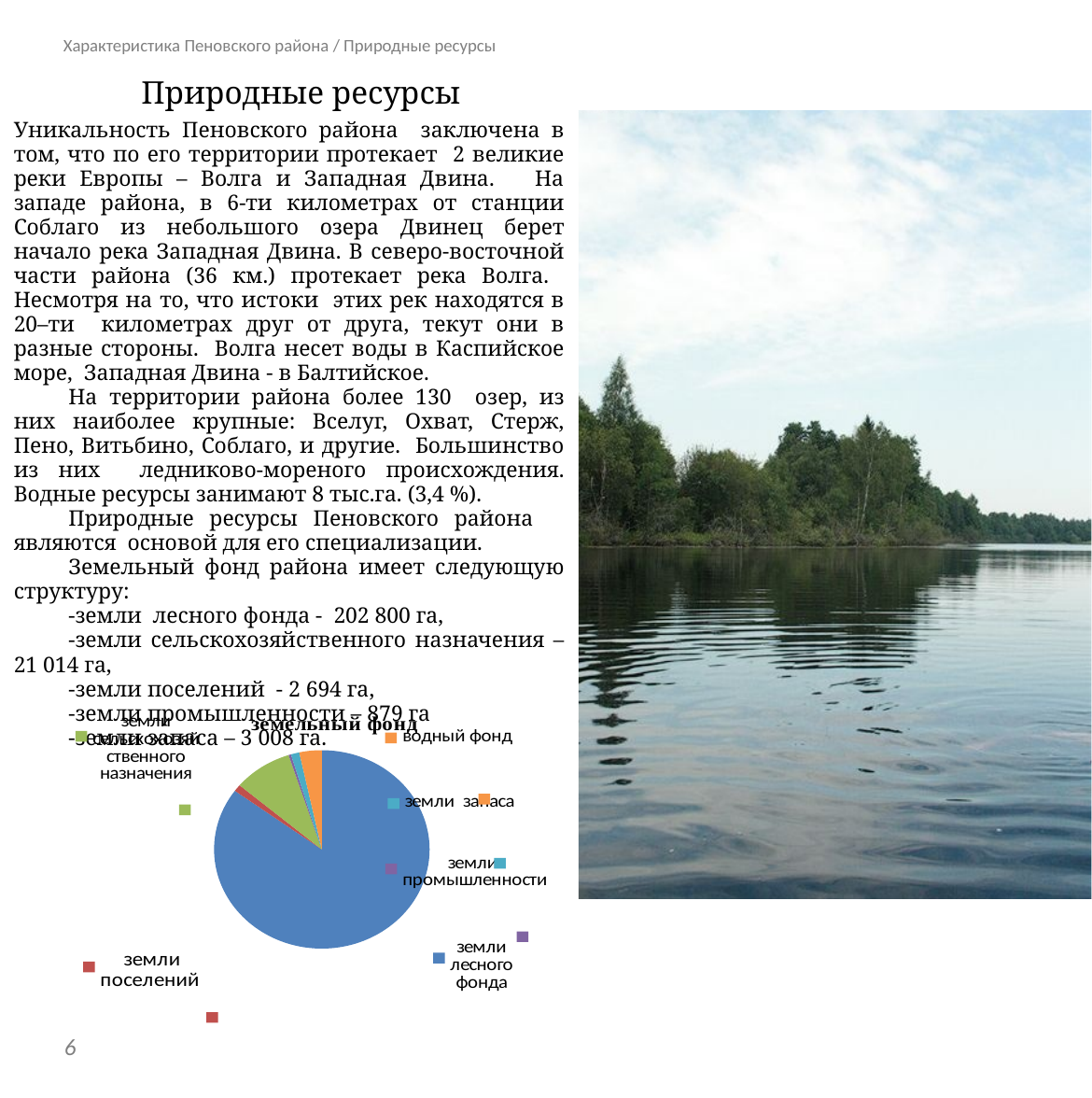
Which slice is larger in the pie chart: земли лесного фонда or водный фонд? земли лесного фонда What is the title of the pie chart? земельный фонд Which slice is larger in the pie chart: земли лесного фонда or земли сельскохозяйственного назначения? земли лесного фонда Which category is the second-largest slice in the pie chart? земли сельскохозяйственного назначения Does the pie chart's largest slice take up more or less than half of the pie? more Which slice is larger in the pie chart: земли сельскохозяйственного назначения or земли поселений? земли сельскохозяйственного назначения How many categories (slices) does the pie chart's legend list? 6 What kind of chart is shown on the slide? pie chart Which category has the largest slice in the pie chart? земли лесного фонда